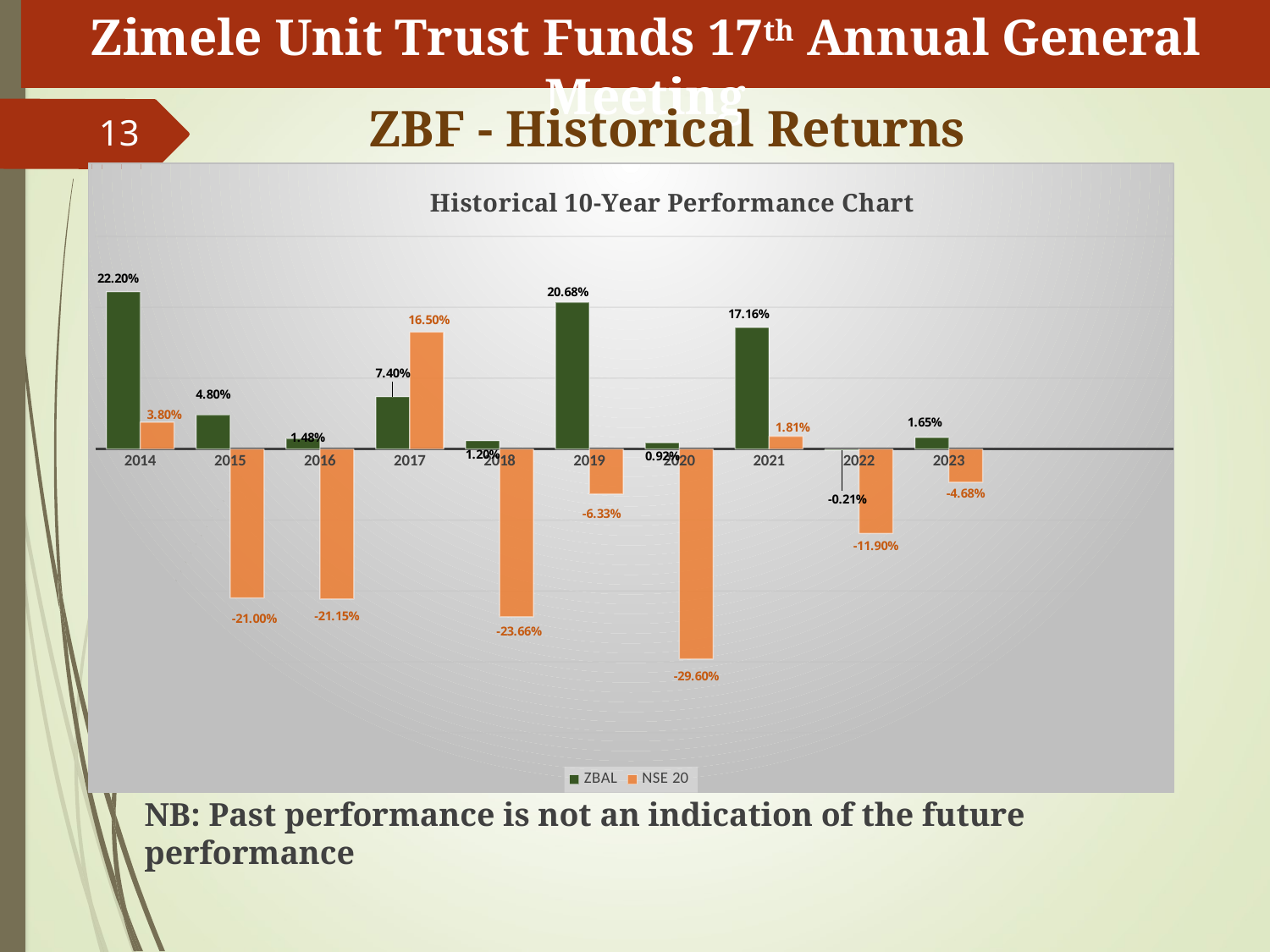
How many years are shown on the x axis? 10 How many series does the legend list? 2 In which year is the NSE 20 return highest? 2017 Which series has the larger return in 2017, ZBAL or NSE 20? NSE 20 What is the ZBAL return for 2022? -0.21% What is the difference between the ZBAL and NSE 20 returns in 2014? 18.40 percentage points What is the NSE 20 return for 2020? -29.60% What is the NSE 20 return for 2017? 16.50% In which year is the NSE 20 return lowest? 2020 In which year is the ZBAL return highest? 2014 What is the ZBAL return for 2014? 22.20% What type of chart is shown? Bar chart